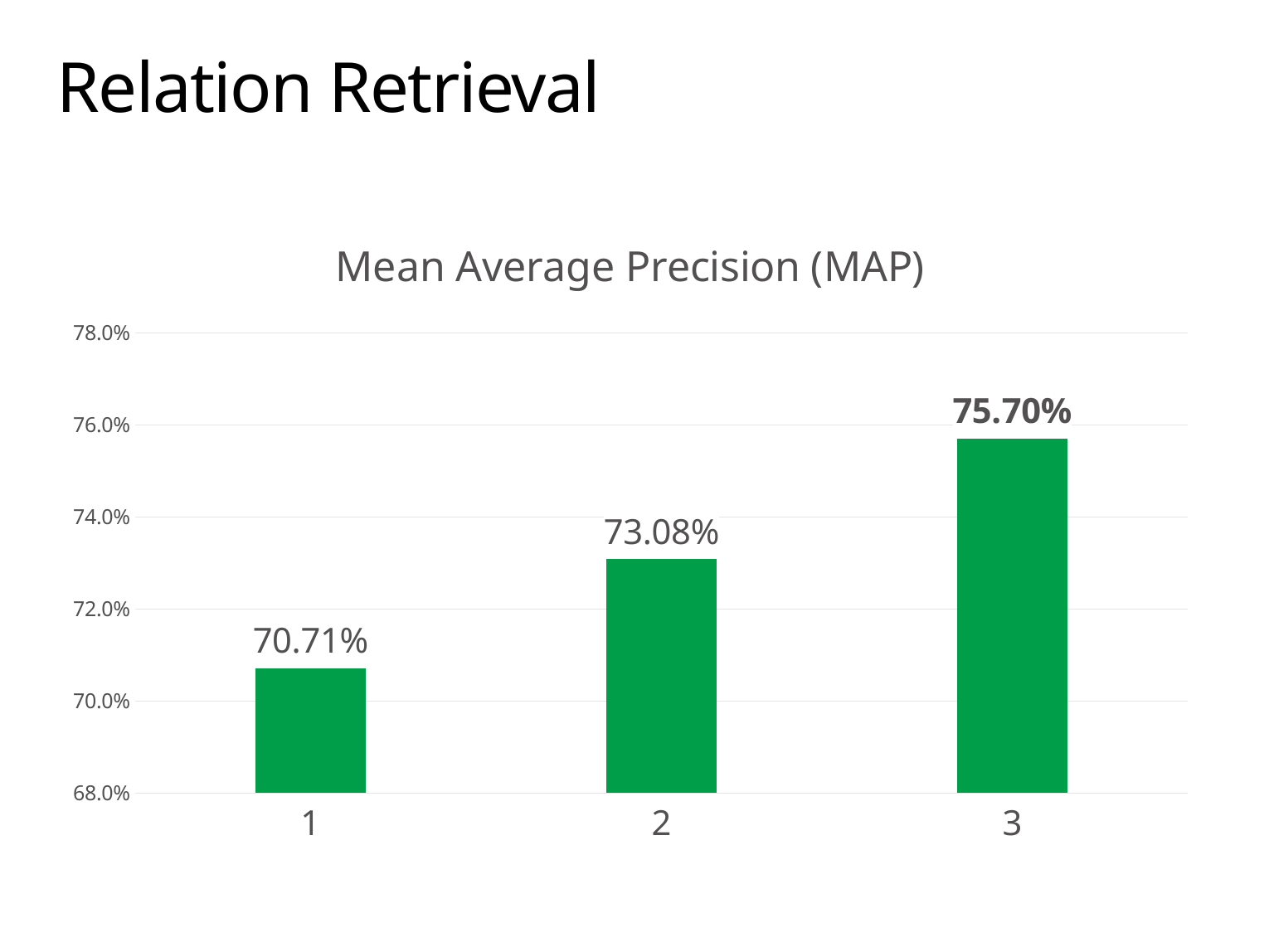
Which category has the lowest Mean Average Precision (MAP)? 1 Which has a higher MAP, category 2 or category 3? 3 Do the MAP values rise or fall from category 1 to category 3? rise What is the Mean Average Precision (MAP) value for category 1? 70.71% How many categories are shown in the chart? 3 Is the MAP value for category 2 greater or less than 72.0%? greater What kind of chart is shown on the slide? bar chart Which category has the highest Mean Average Precision (MAP)? 3 What is the difference in MAP between category 3 and category 1? 4.99% What is the Mean Average Precision (MAP) value for category 3? 75.70% What is the difference in MAP between category 2 and category 1? 2.37% What is the Mean Average Precision (MAP) value for category 2? 73.08%